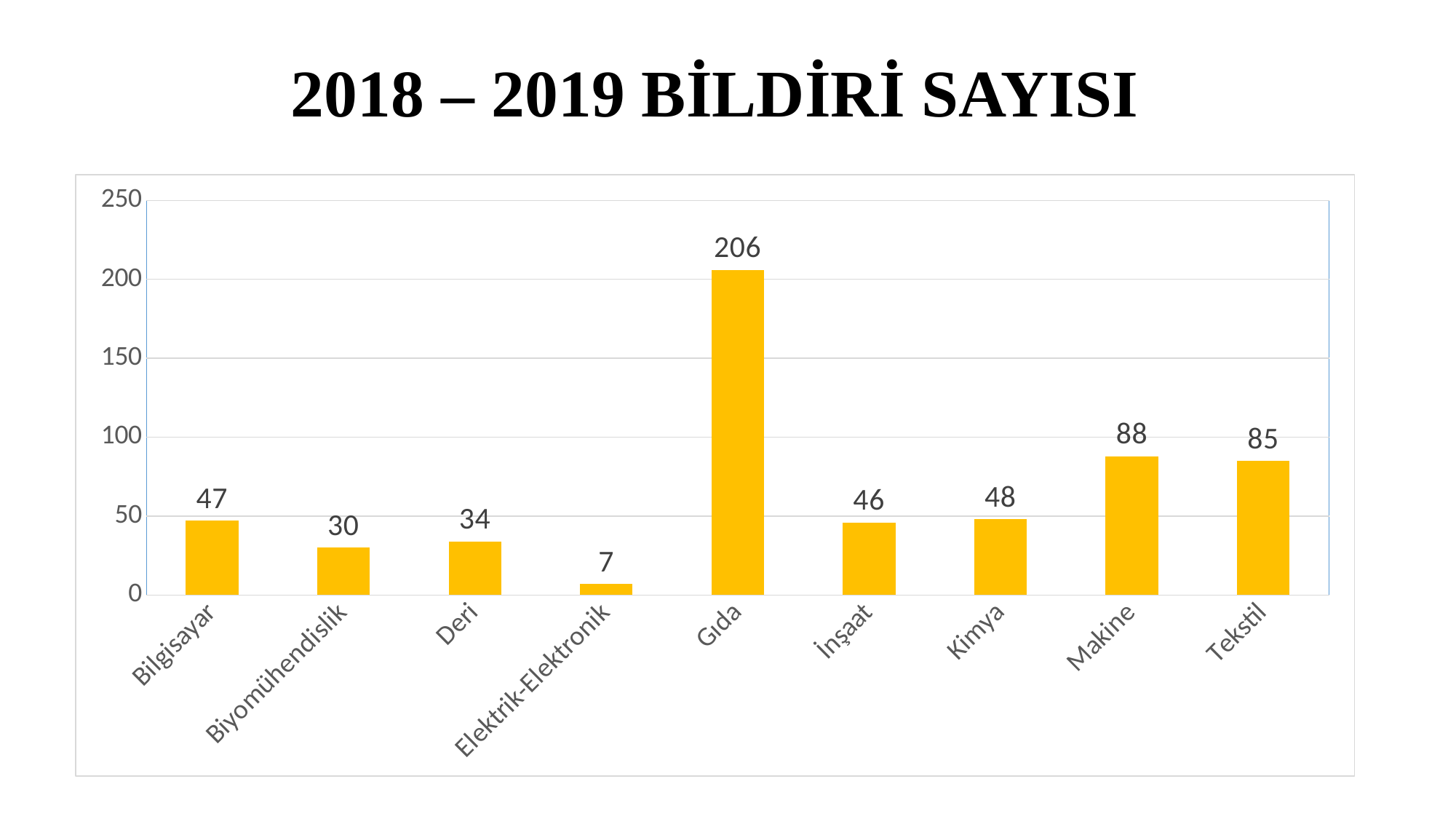
Which category has the highest value? Gıda Which is larger, the value for Deri or the value for İnşaat? İnşaat What is the value for Elektrik-Elektronik? 7 What kind of chart is shown on the slide? bar chart What is the value for Gıda? 206 Which category has the lowest value? Elektrik-Elektronik Is the value for Gıda greater or less than 200? greater What is the title of the slide? 2018 – 2019 BİLDİRİ SAYISI How many categories are shown on the x axis? 9 What is the value for Makine? 88 What is the difference between the values for Bilgisayar and Biyomühendislik? 17 What is the difference between the values for Makine and Tekstil? 3